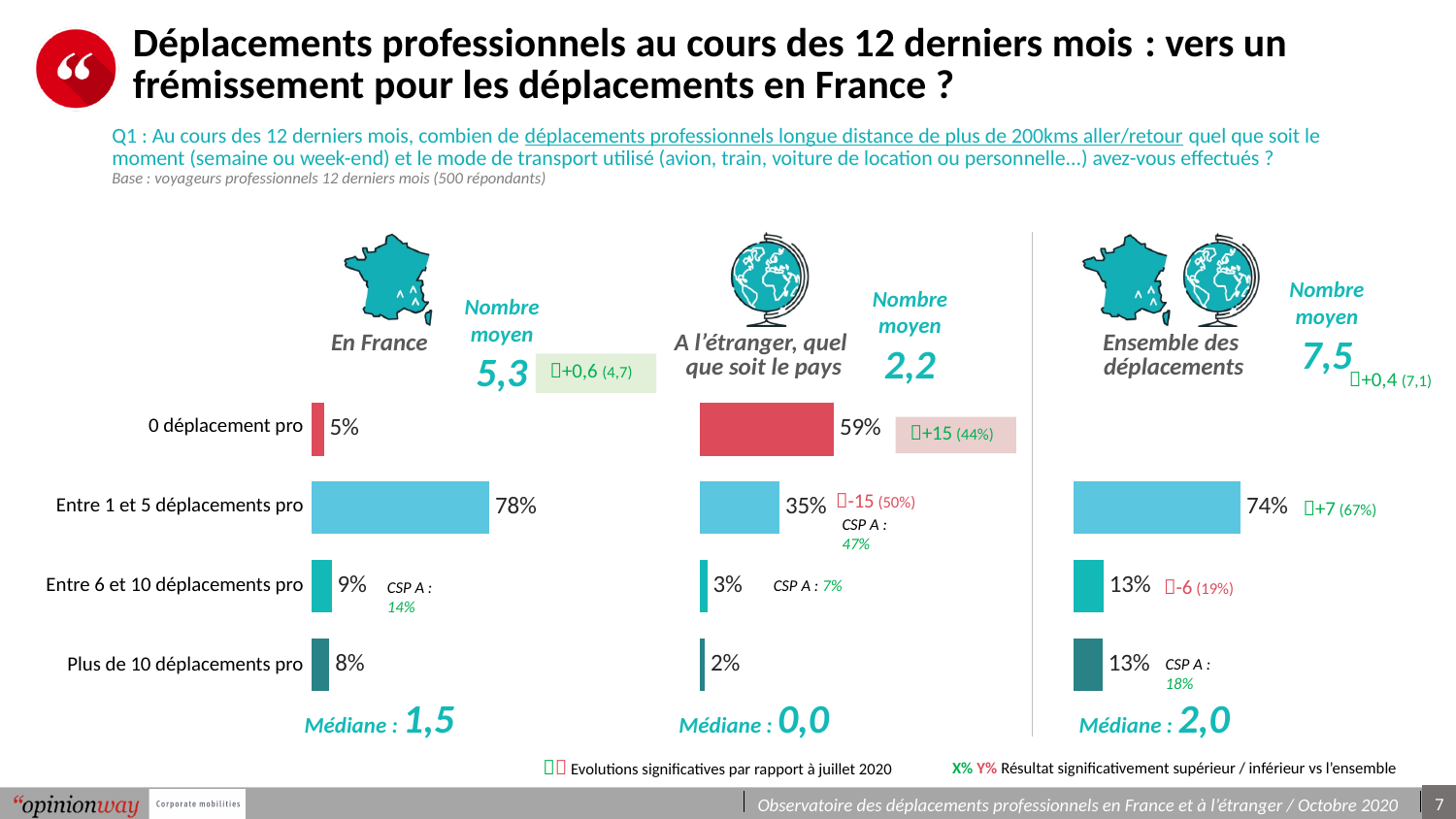
In the 'A l'étranger, quel que soit le pays' chart, what is the difference between the value for '0 déplacement pro' and the value for 'Entre 1 et 5 déplacements pro'? 24% In the 'A l'étranger, quel que soit le pays' chart, which category has the lowest value? Plus de 10 déplacements pro How many categories of trip counts are listed on the left of the charts? 4 What is the average number ('Nombre moyen') of professional trips shown for 'Ensemble des déplacements'? 7,5 In the 'Ensemble des déplacements' chart, what percentage of respondents made between 6 and 10 professional trips? 13% What is the median ('Médiane') shown under the 'En France' chart? 1,5 Which is larger: the value for 'Plus de 10 déplacements pro' in the 'En France' chart or in the 'A l'étranger, quel que soit le pays' chart? En France In the 'En France' chart, what percentage of respondents made between 1 and 5 professional trips? 78% In the 'A l'étranger, quel que soit le pays' chart, what percentage of respondents made 0 professional trips? 59% In the 'En France' chart, which category has the highest value? Entre 1 et 5 déplacements pro In the 'En France' chart, what is the difference between the value for 'Entre 1 et 5 déplacements pro' and the value for 'Entre 6 et 10 déplacements pro'? 69% What type of chart is used to show the distribution of professional trips on this slide? Bar chart